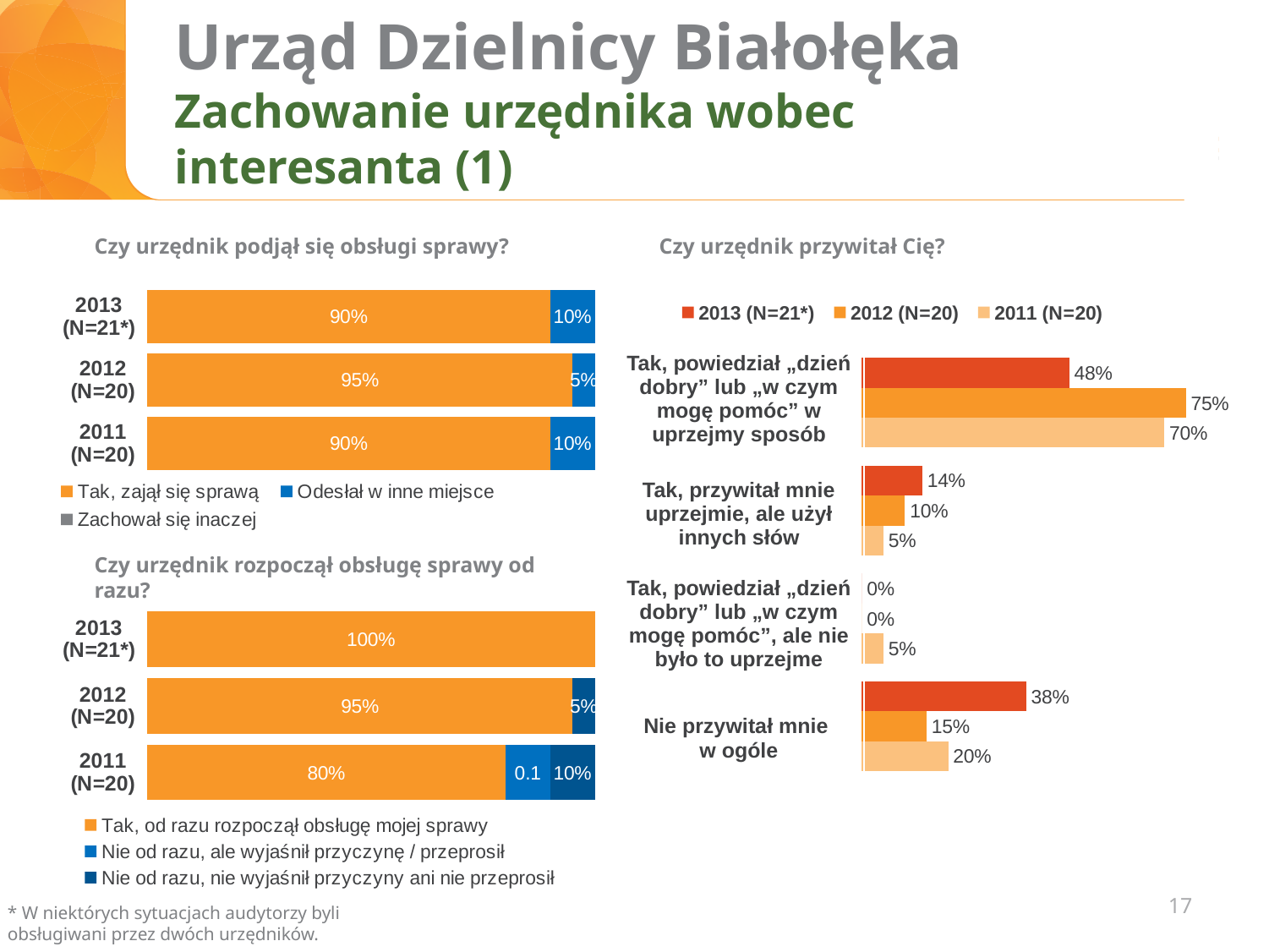
In the chart "Czy urzędnik przywitał Cię?", which is larger for "Nie przywitał mnie w ogóle": 2012 (N=20) or 2011 (N=20)? 2011 (N=20) In the chart "Czy urzędnik podjął się obsługi sprawy?", how many series does the legend list? 3 In the chart "Czy urzędnik przywitał Cię?", what is the value for 2012 (N=20) in the category "Tak, powiedział „dzień dobry” lub „w czym mogę pomóc” w uprzejmy sposób"? 75% In the chart "Czy urzędnik przywitał Cię?", what is the difference between the 2012 (N=20) and 2013 (N=21*) values for "Tak, powiedział „dzień dobry” lub „w czym mogę pomóc” w uprzejmy sposób"? 27% In the chart "Czy urzędnik podjął się obsługi sprawy?", what is the value for "Tak, zajął się sprawą" in 2012 (N=20)? 95% In the chart "Czy urzędnik rozpoczął obsługę sprawy od razu?", what is the value for "Tak, od razu rozpoczął obsługę mojej sprawy" in 2013 (N=21*)? 100% In the chart "Czy urzędnik przywitał Cię?", how many categories are shown? 4 In the chart "Czy urzędnik podjął się obsługi sprawy?", what is the value for "Odesłał w inne miejsce" in 2013 (N=21*)? 10% What kind of chart is "Czy urzędnik przywitał Cię?"? Bar chart In the chart "Czy urzędnik rozpoczął obsługę sprawy od razu?", what is the value for "Nie od razu, nie wyjaśnił przyczyny ani nie przeprosił" in 2011 (N=20)? 10% In the chart "Czy urzędnik przywitał Cię?", what is the value for 2013 (N=21*) in the category "Nie przywitał mnie w ogóle"? 38% In the chart "Czy urzędnik rozpoczął obsługę sprawy od razu?", which year has the lowest value for "Tak, od razu rozpoczął obsługę mojej sprawy"? 2011 (N=20)